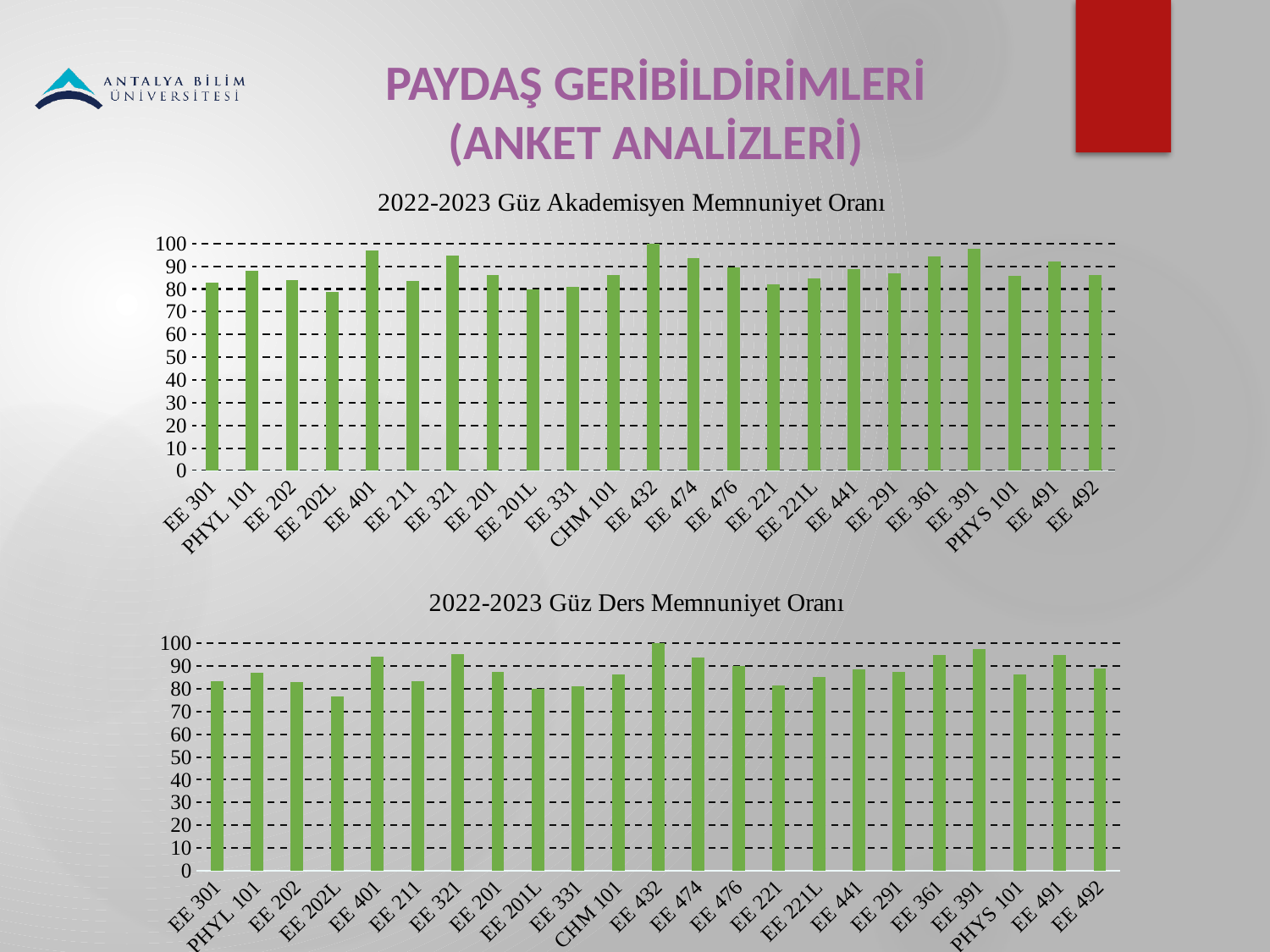
In the top chart '2022-2023 Güz Akademisyen Memnuniyet Oranı', is the value for EE 401 greater or less than 90? greater In the bottom chart '2022-2023 Güz Ders Memnuniyet Oranı', is the value for EE 391 greater or less than 90? greater In the top chart '2022-2023 Güz Akademisyen Memnuniyet Oranı', which category has the lowest value? EE 202L In the top chart '2022-2023 Güz Akademisyen Memnuniyet Oranı', is the value for EE 202L greater or less than 80? less How many categories are shown on the x axis of the bottom chart '2022-2023 Güz Ders Memnuniyet Oranı'? 23 In the bottom chart '2022-2023 Güz Ders Memnuniyet Oranı', which category has the lowest value? EE 202L In the top chart '2022-2023 Güz Akademisyen Memnuniyet Oranı', which is larger, the value for EE 401 or the value for EE 202L? EE 401 In the bottom chart '2022-2023 Güz Ders Memnuniyet Oranı', which category has the highest value? EE 432 What is the title of the bottom chart on the slide? 2022-2023 Güz Ders Memnuniyet Oranı What type of chart is the top chart titled '2022-2023 Güz Akademisyen Memnuniyet Oranı'? bar chart In the top chart '2022-2023 Güz Akademisyen Memnuniyet Oranı', which category has the highest value? EE 432